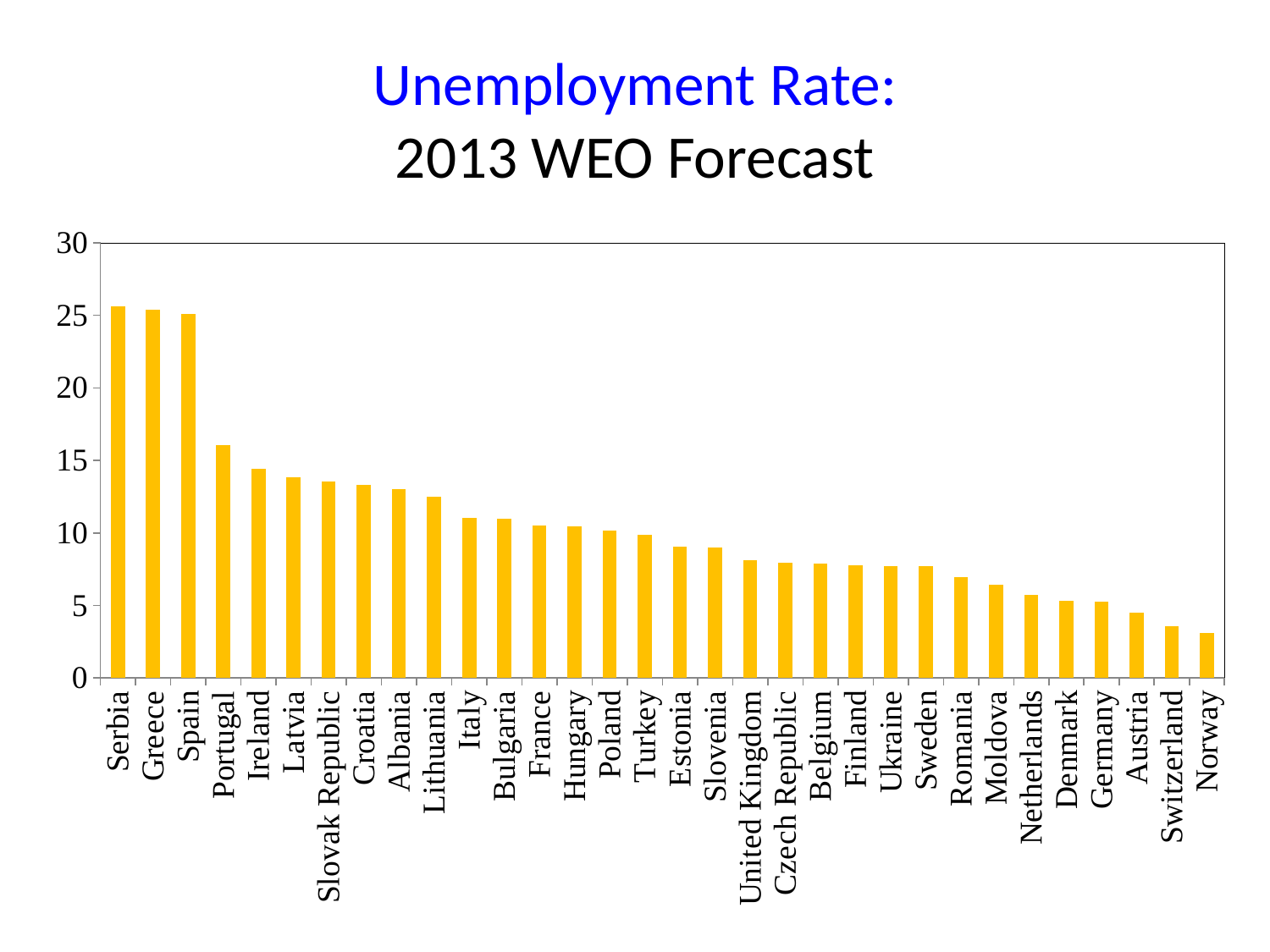
Which country has the lowest forecast unemployment rate? Norway How many countries are shown on the chart? 32 Is the value for Portugal greater or less than 15? greater Which has the higher forecast unemployment rate, Portugal or Ireland? Portugal What is the title of the chart? Unemployment Rate: 2013 WEO Forecast Is the value for Spain greater or less than 20? greater Is the value for Moldova greater or less than 5? greater What kind of chart is shown on the slide? bar chart Do the values rise or fall moving from left to right along the x axis? fall